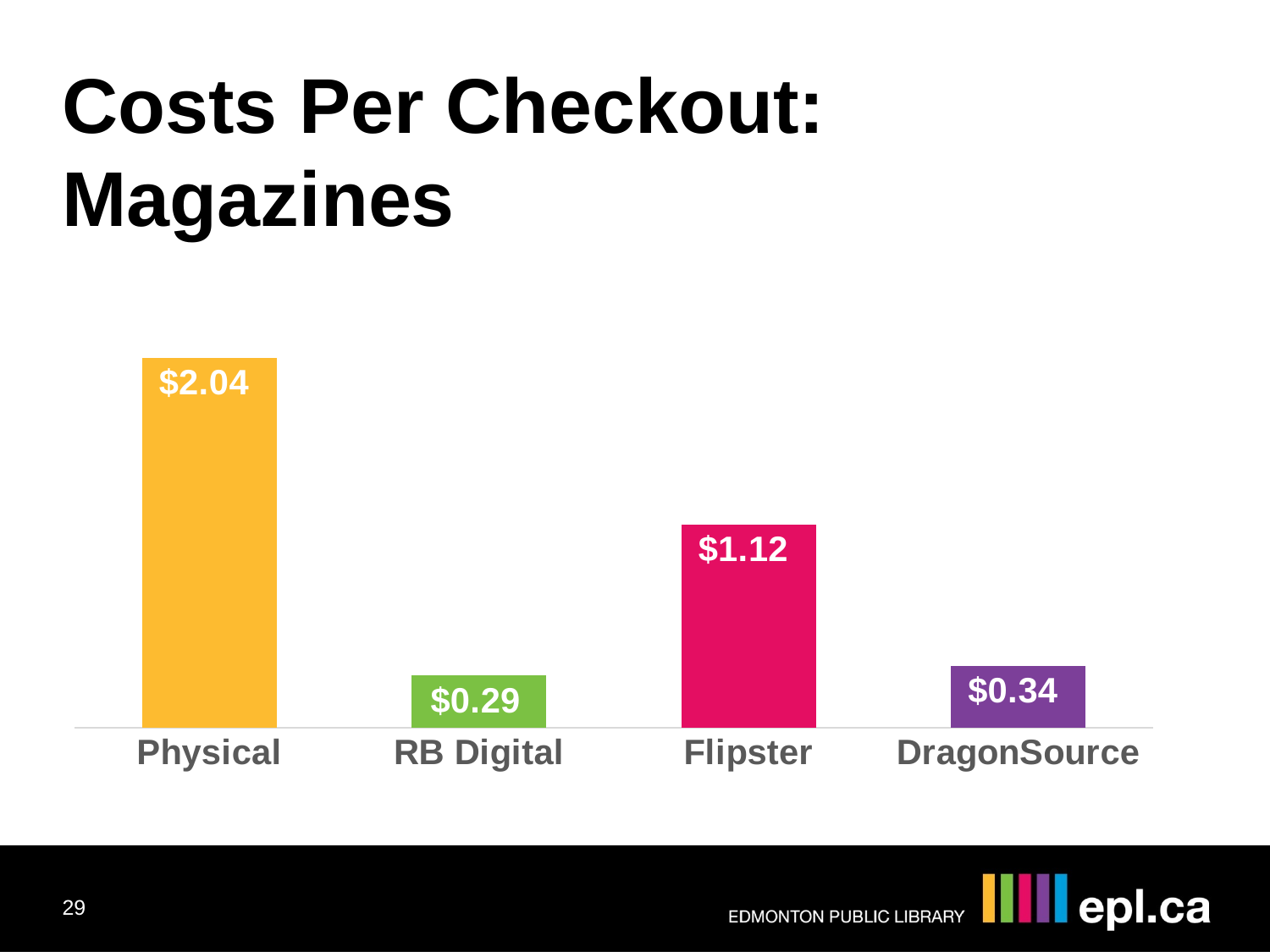
What is the cost per checkout for DragonSource? $0.34 What is the cost per checkout for Physical magazines? $2.04 What is the difference in cost per checkout between DragonSource and RB Digital? $0.05 What kind of chart is shown on the slide? Bar chart What is the difference in cost per checkout between Physical and Flipster? $0.92 Which category has the lowest cost per checkout? RB Digital Which category has the highest cost per checkout? Physical What is the cost per checkout for Flipster? $1.12 What is the title of the slide? Costs Per Checkout: Magazines How many categories are shown in the chart? 4 Which has a higher cost per checkout, Flipster or DragonSource? Flipster What is the cost per checkout for RB Digital? $0.29